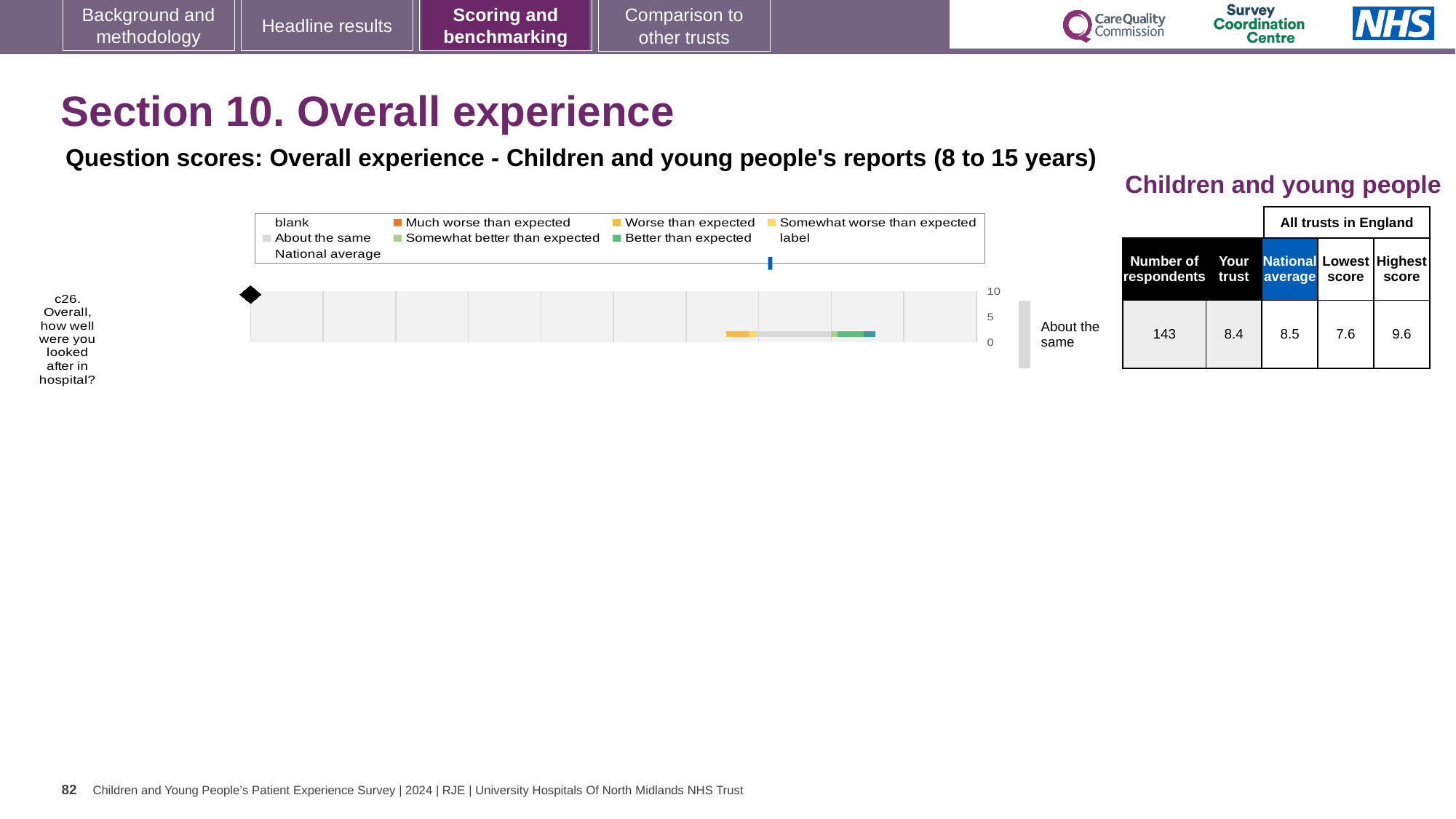
According to the table beside the chart, what is the national average score for question c26? 8.5 According to the table beside the chart, what is the highest score among all trusts in England for question c26? 9.6 Which survey question is plotted in the chart? c26. Overall, how well were you looked after in hospital? According to the table beside the chart, what is the 'Your trust' score for question c26? 8.4 According to the table beside the chart, what is the lowest score among all trusts in England for question c26? 7.6 What kind of chart is used to show the question score for c26? bar chart How many survey questions are plotted in the chart? 1 What benchmark rating is shown next to the chart for question c26? About the same According to the table beside the chart, how many respondents answered question c26? 143 What is the maximum value shown on the chart's score axis? 10 Which is larger for question c26: the 'Your trust' score or the national average score? National average What is the difference between the highest score and the lowest score for question c26 in the table? 2.0